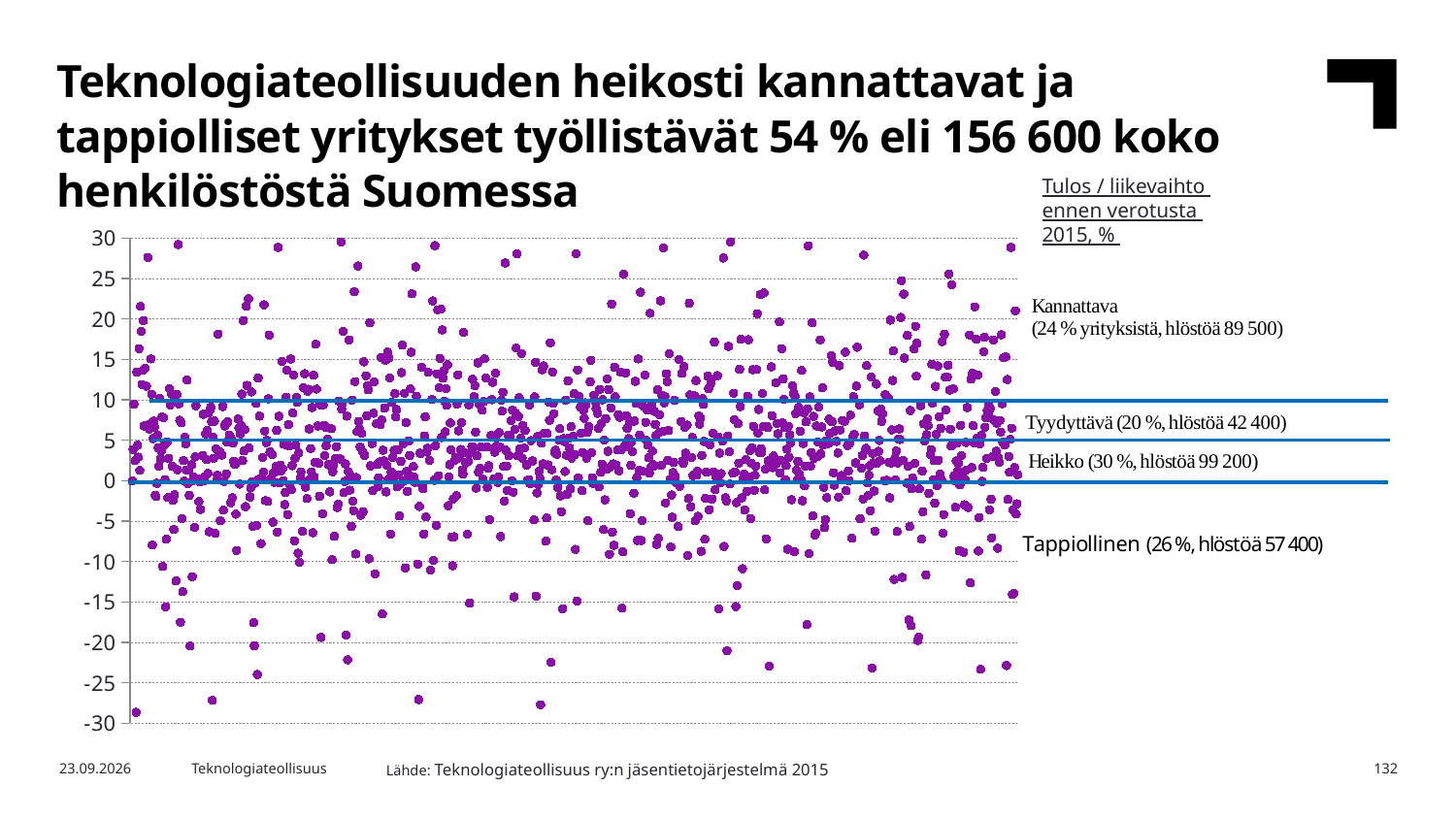
How many personnel (hlöstöä) does the chart annotation give for the Heikko category? 99 200 How many personnel (hlöstöä) does the chart annotation give for the Tappiollinen category? 57 400 What percentage of companies does the chart annotation give for the Tyydyttävä category? 20 % What kind of chart is shown on the slide? scatter chart Which category has more personnel, Kannattava or Tappiollinen? Kannattava How many profitability categories (Kannattava, Tyydyttävä, Heikko, Tappiollinen) are labelled on the chart? 4 Which labelled category has the smallest number of personnel? Tyydyttävä Which labelled category has the largest number of personnel? Heikko What is the difference in personnel between the Heikko and Tappiollinen categories? 41 800 According to the chart annotation, how many personnel (hlöstöä) are in the Kannattava category? 89 500 What is the highest value shown on the vertical axis of the chart? 30 What is the title of the chart? Tulos / liikevaihto ennen verotusta 2015, %